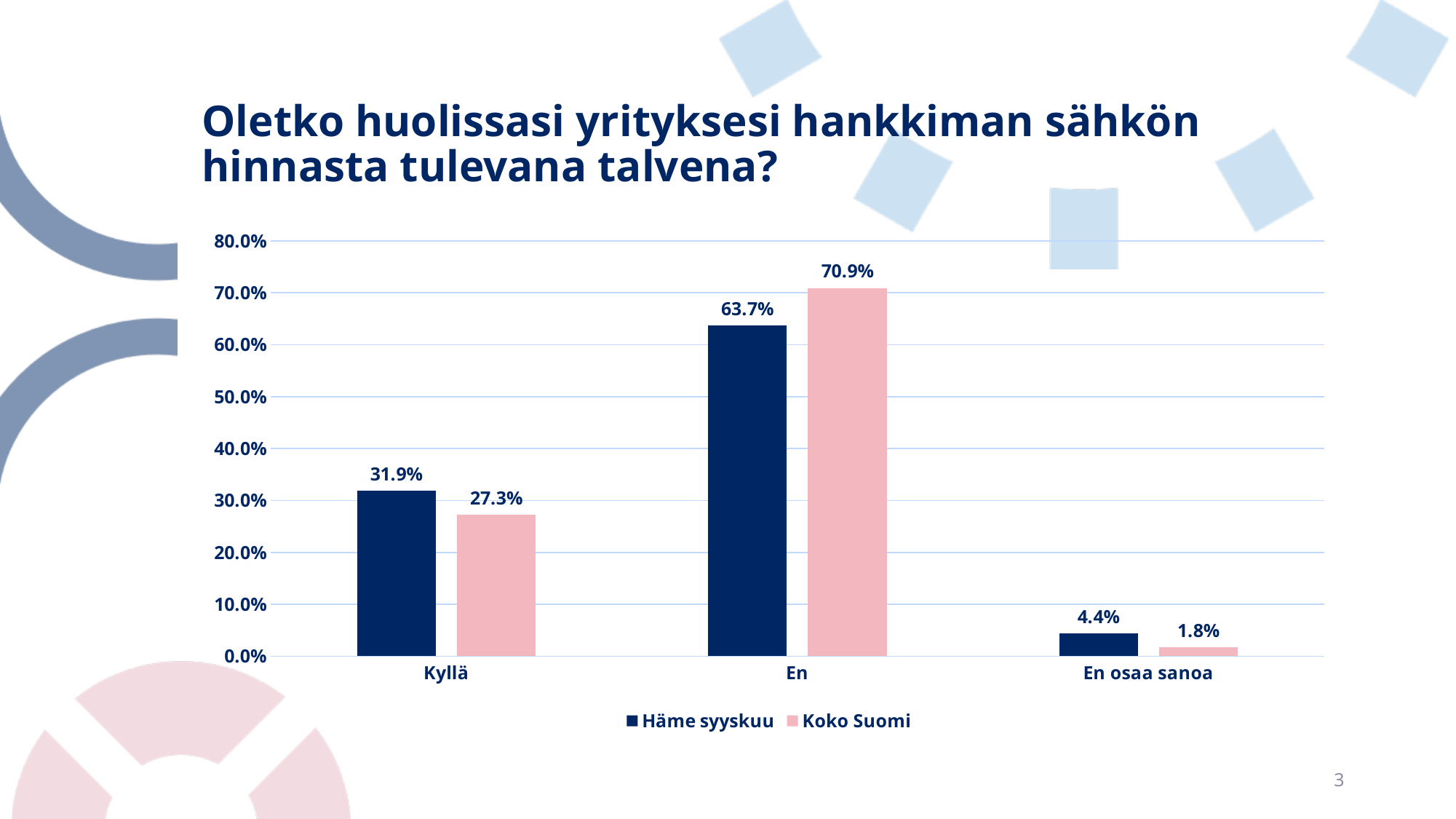
How many series does the legend list? 2 What kind of chart is shown on the slide? Bar chart What is the value for Häme syyskuu in the En osaa sanoa category? 4.4% Which category has the highest value for Koko Suomi? En Which category has the lowest value for Häme syyskuu? En osaa sanoa What is the value for Häme syyskuu in the Kyllä category? 31.9% What is the value for Koko Suomi in the En category? 70.9% What is the value for Koko Suomi in the Kyllä category? 27.3% How many categories are shown on the x axis? 3 What is the difference between Koko Suomi and Häme syyskuu in the En category? 7.2% Which is larger in the Kyllä category, Häme syyskuu or Koko Suomi? Häme syyskuu Is the value for Häme syyskuu in the En category greater or less than 60.0%? greater